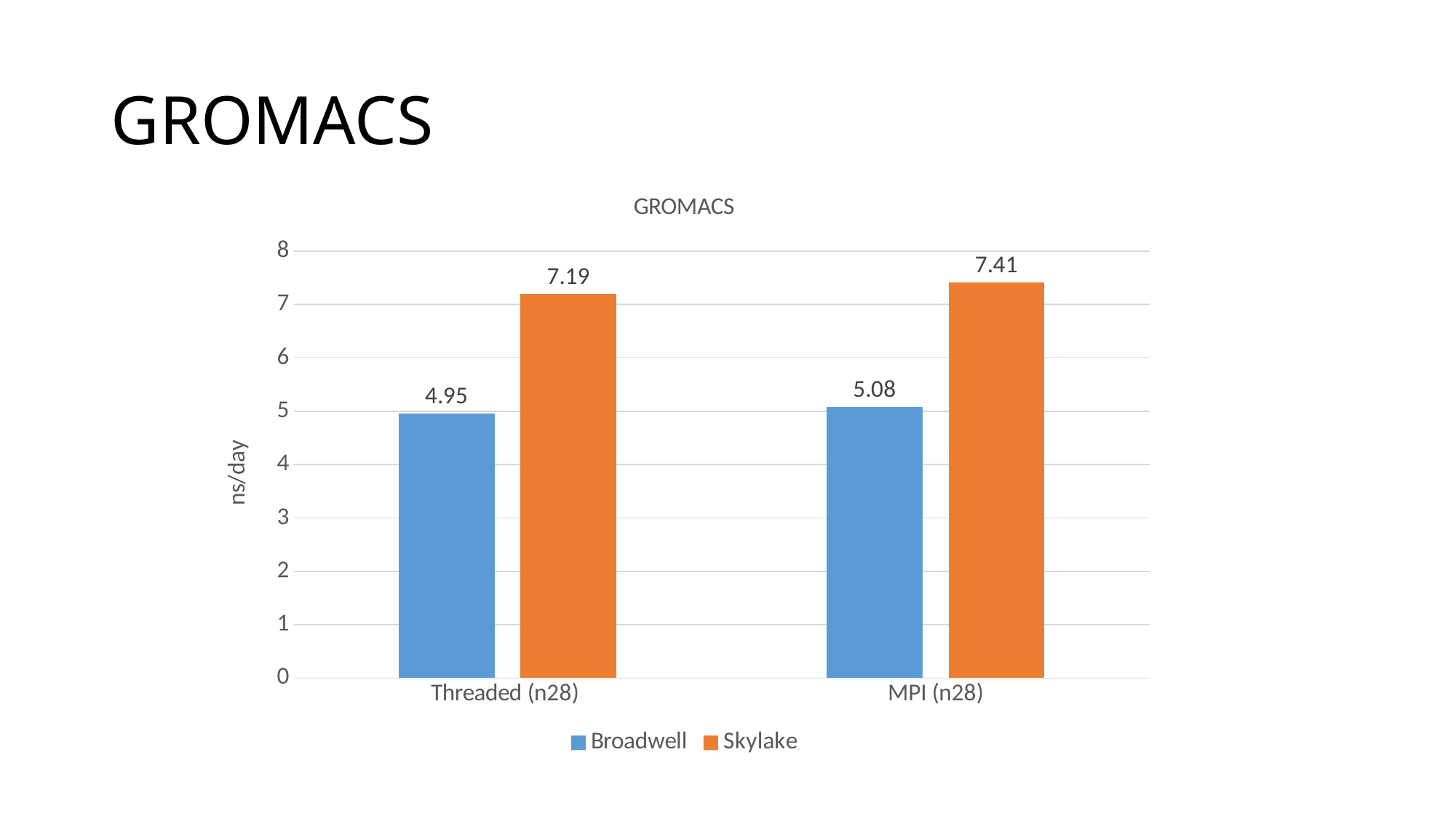
How many series does the legend list? 2 What is the Broadwell value for Threaded (n28)? 4.95 How many categories are shown on the x axis? 2 What is the difference between the Skylake values for MPI (n28) and Threaded (n28)? 0.22 What is the Skylake value for MPI (n28)? 7.41 What is the difference between the Skylake and Broadwell values for MPI (n28)? 2.33 What is the Broadwell value for MPI (n28)? 5.08 Which bar has the highest value on the chart? Skylake, MPI (n28) What is the Skylake value for Threaded (n28)? 7.19 Which is larger for Threaded (n28): Broadwell or Skylake? Skylake Which bar has the lowest value on the chart? Broadwell, Threaded (n28) What is the label on the vertical axis? ns/day